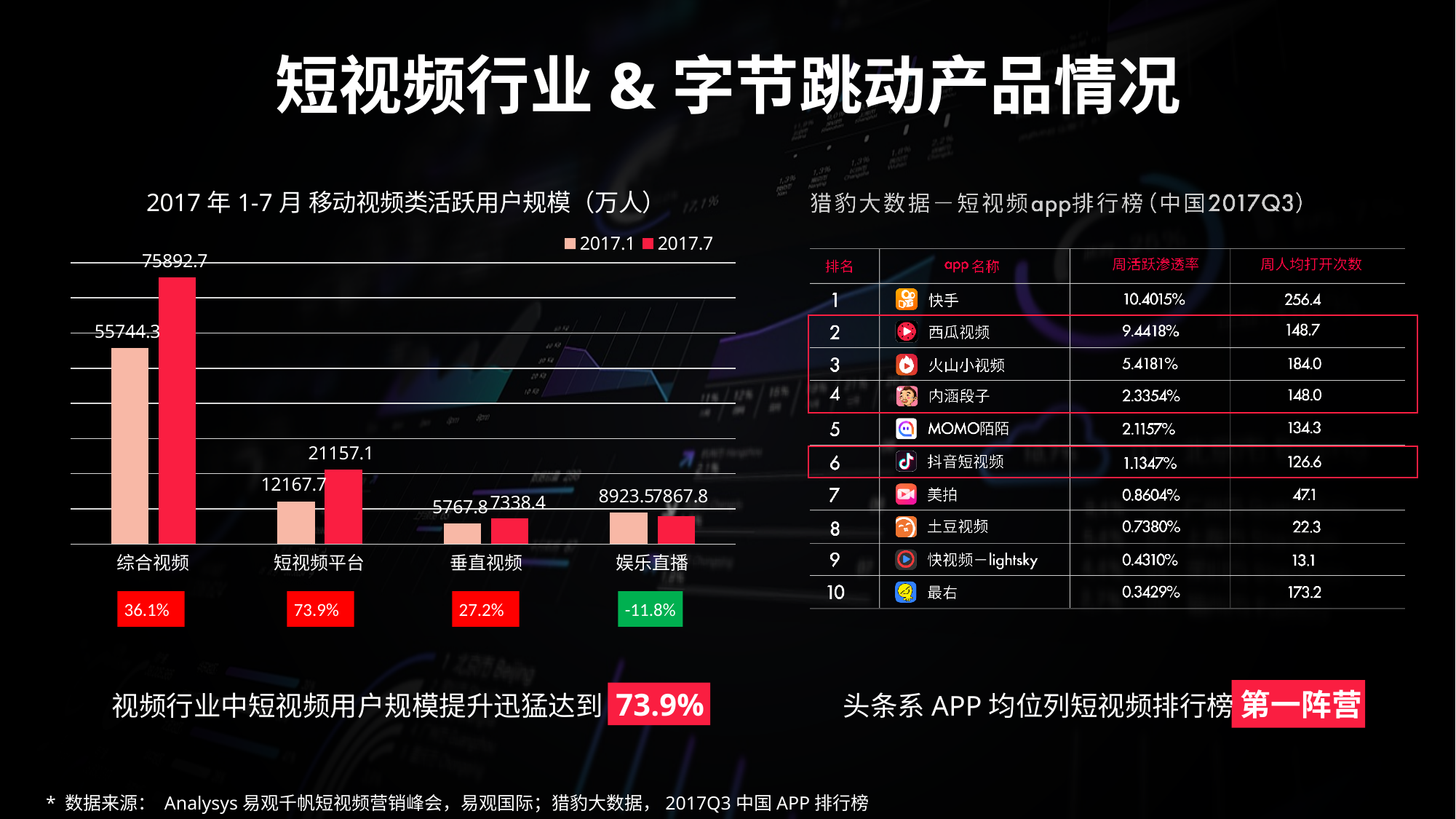
What type of chart is shown on the left of the slide? bar chart In the bar chart, what is the 2017.1 value for 娱乐直播? 8923.5 In the bar chart, what is the difference between the 2017.7 and 2017.1 values for 短视频平台? 8989.4 What growth percentage is shown below 短视频平台 in the bar chart? 73.9% How many series does the legend of the bar chart list? 2 In the bar chart, what is the 2017.7 value for 垂直视频? 7338.4 In the bar chart, which category has the highest 2017.7 value? 综合视频 In the bar chart, which is larger for 娱乐直播: the 2017.1 value or the 2017.7 value? 2017.1 In the bar chart, which category has the lowest 2017.1 value? 垂直视频 How many categories are shown on the x axis of the bar chart? 4 In the bar chart, what is the 2017.1 value for 短视频平台? 12167.7 In the bar chart, what is the 2017.7 value for 综合视频? 75892.7